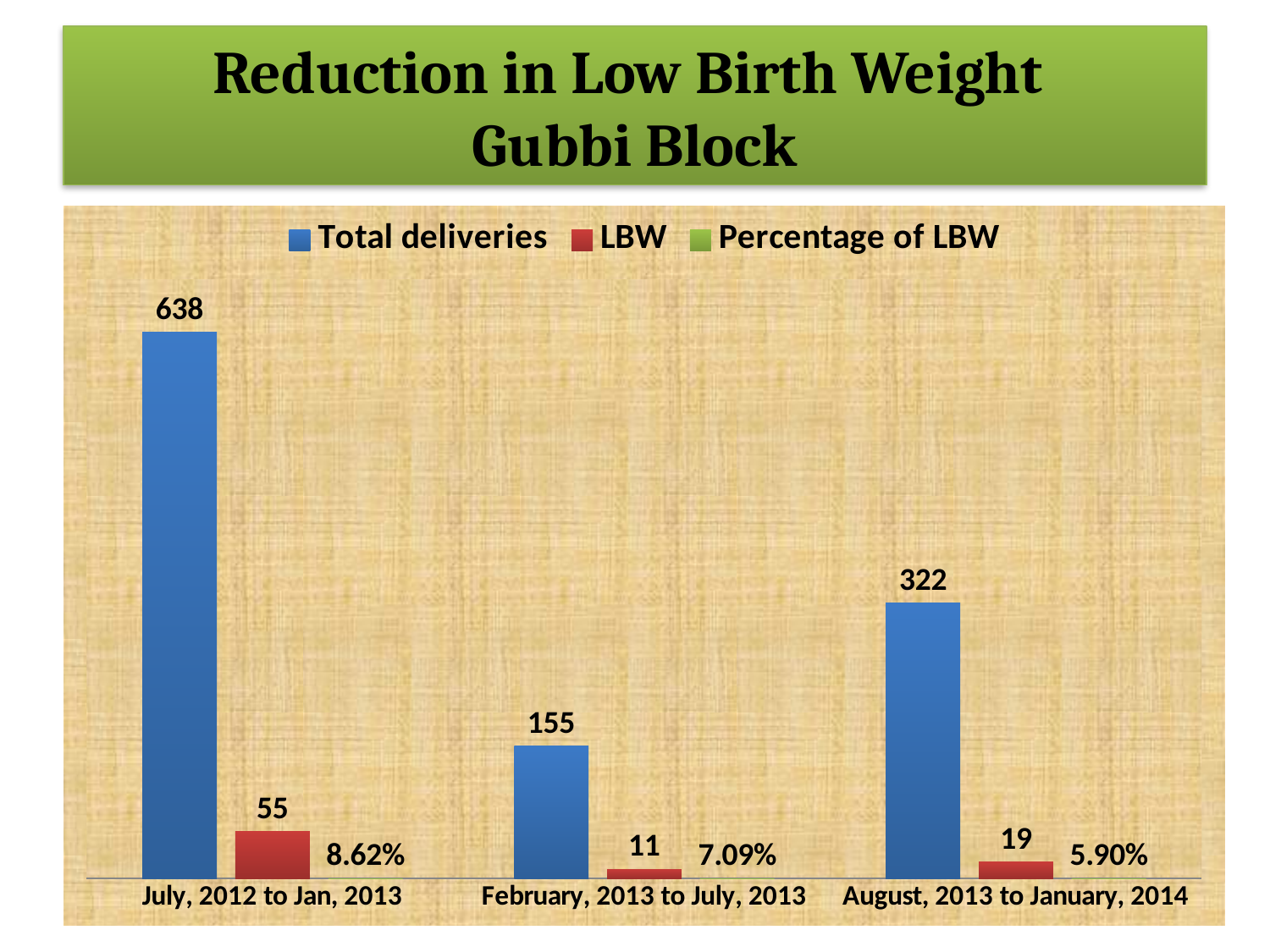
What kind of chart is shown on the slide? Bar chart Which is larger: the LBW value for July, 2012 to Jan, 2013 or for August, 2013 to January, 2014? July, 2012 to Jan, 2013 Does the Percentage of LBW rise or fall across the periods from left to right? Fall How many periods are shown on the x axis? 3 Which period has the lowest LBW value? February, 2013 to July, 2013 What is the Total deliveries value for August, 2013 to January, 2014? 322 What is the LBW value for February, 2013 to July, 2013? 11 What is the difference in Total deliveries between July, 2012 to Jan, 2013 and August, 2013 to January, 2014? 316 How many series does the legend list? 3 Which period has the highest Total deliveries? July, 2012 to Jan, 2013 What is the Percentage of LBW for August, 2013 to January, 2014? 5.90% What is the value of Total deliveries for July, 2012 to Jan, 2013? 638